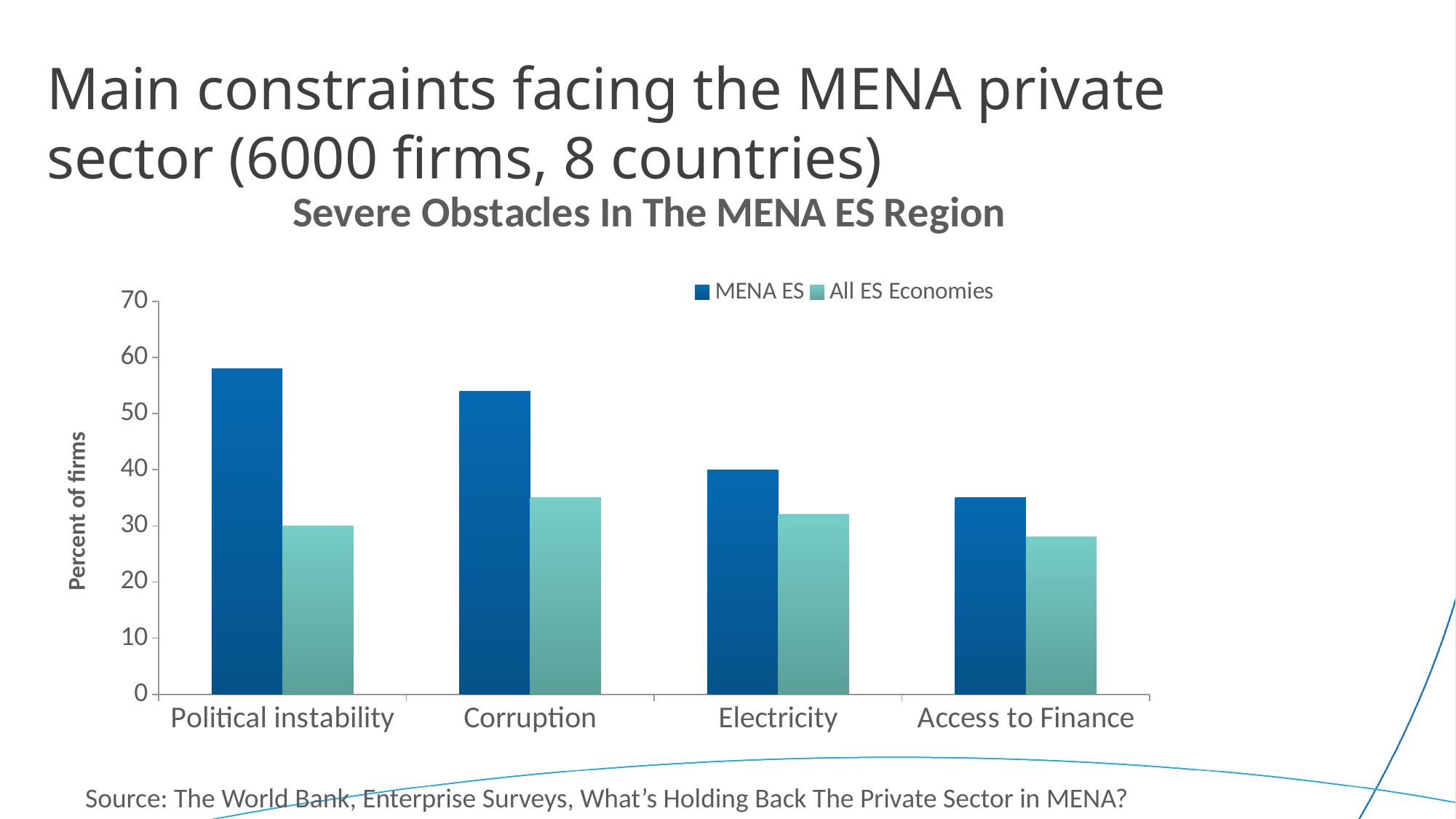
Do the MENA ES values rise or fall moving from Political instability to Access to Finance along the x axis? fall What kind of chart is shown on the slide? bar chart Is the All ES Economies value for Access to Finance greater or less than 30? less Which category has the highest value for the MENA ES series? Political instability What is the label on the vertical axis of the chart? Percent of firms How many series does the legend list? 2 For Political instability, which series has the larger value, MENA ES or All ES Economies? MENA ES Which category has the highest value for the All ES Economies series? Corruption Which category has the lowest value for the MENA ES series? Access to Finance Is the MENA ES value for Corruption greater or less than 50? greater Which category has the lowest value for the All ES Economies series? Access to Finance How many obstacle categories are shown on the x axis? 4